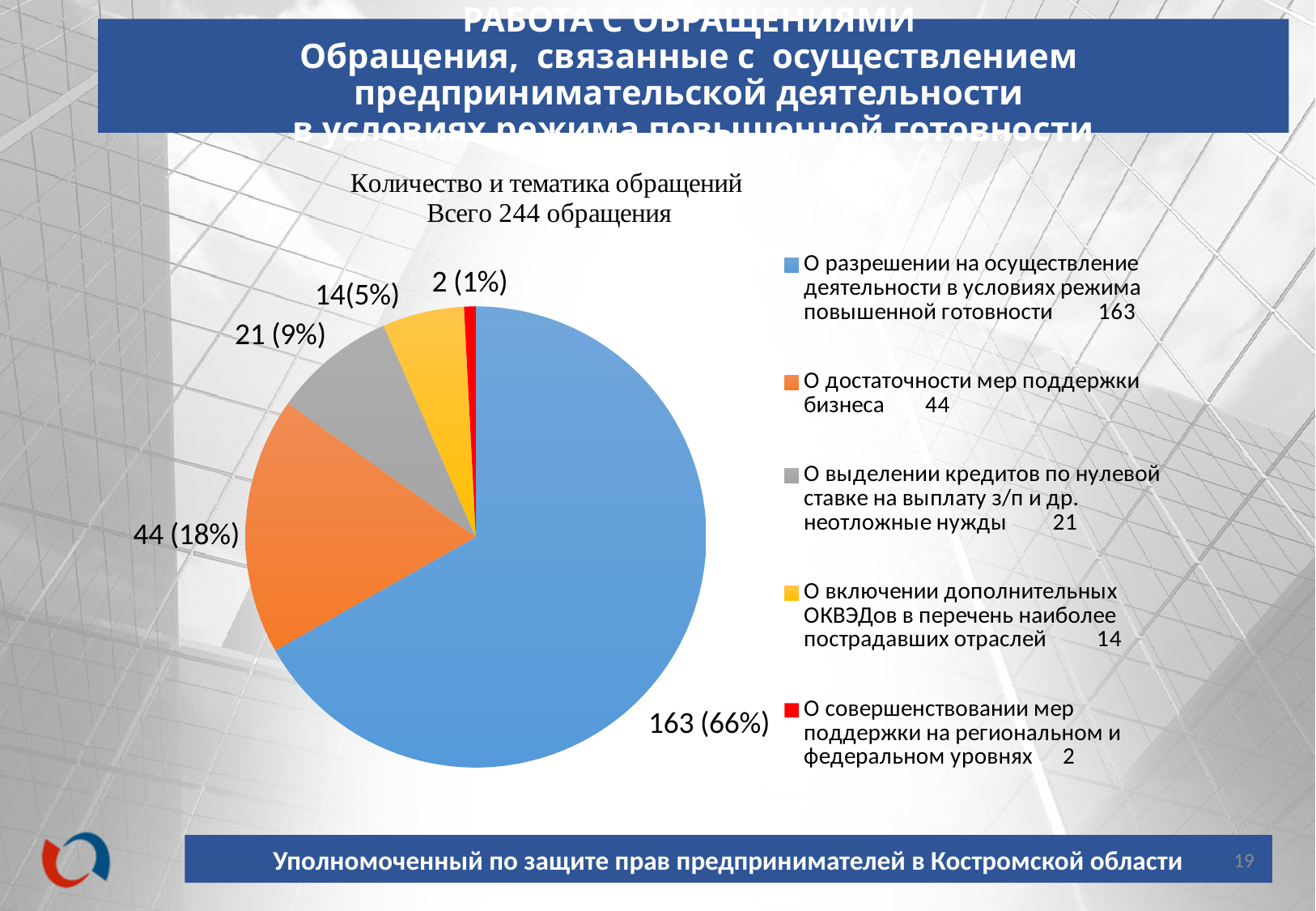
How many entries does the legend of the pie chart list? 5 Which category has the largest slice of the pie? О разрешении на осуществление деятельности в условиях режима повышенной готовности How many slices does the pie chart have? 5 What is the value for "О выделении кредитов по нулевой ставке на выплату з/п и др. неотложные нужды"? 21 What share of the pie does "О разрешении на осуществление деятельности в условиях режима повышенной готовности" represent? 66% What is the difference between the values for "О достаточности мер поддержки бизнеса" and "О выделении кредитов по нулевой ставке на выплату з/п и др. неотложные нужды"? 23 What kind of chart is shown on the slide? pie chart Which category has the smallest slice of the pie? О совершенствовании мер поддержки на региональном и федеральном уровнях What is the value for "О достаточности мер поддержки бизнеса"? 44 What share of the pie does "О включении дополнительных ОКВЭДов в перечень наиболее пострадавших отраслей" represent? 5% What total number of appeals is stated in the chart title? 244 What is the value for "О совершенствовании мер поддержки на региональном и федеральном уровнях"? 2